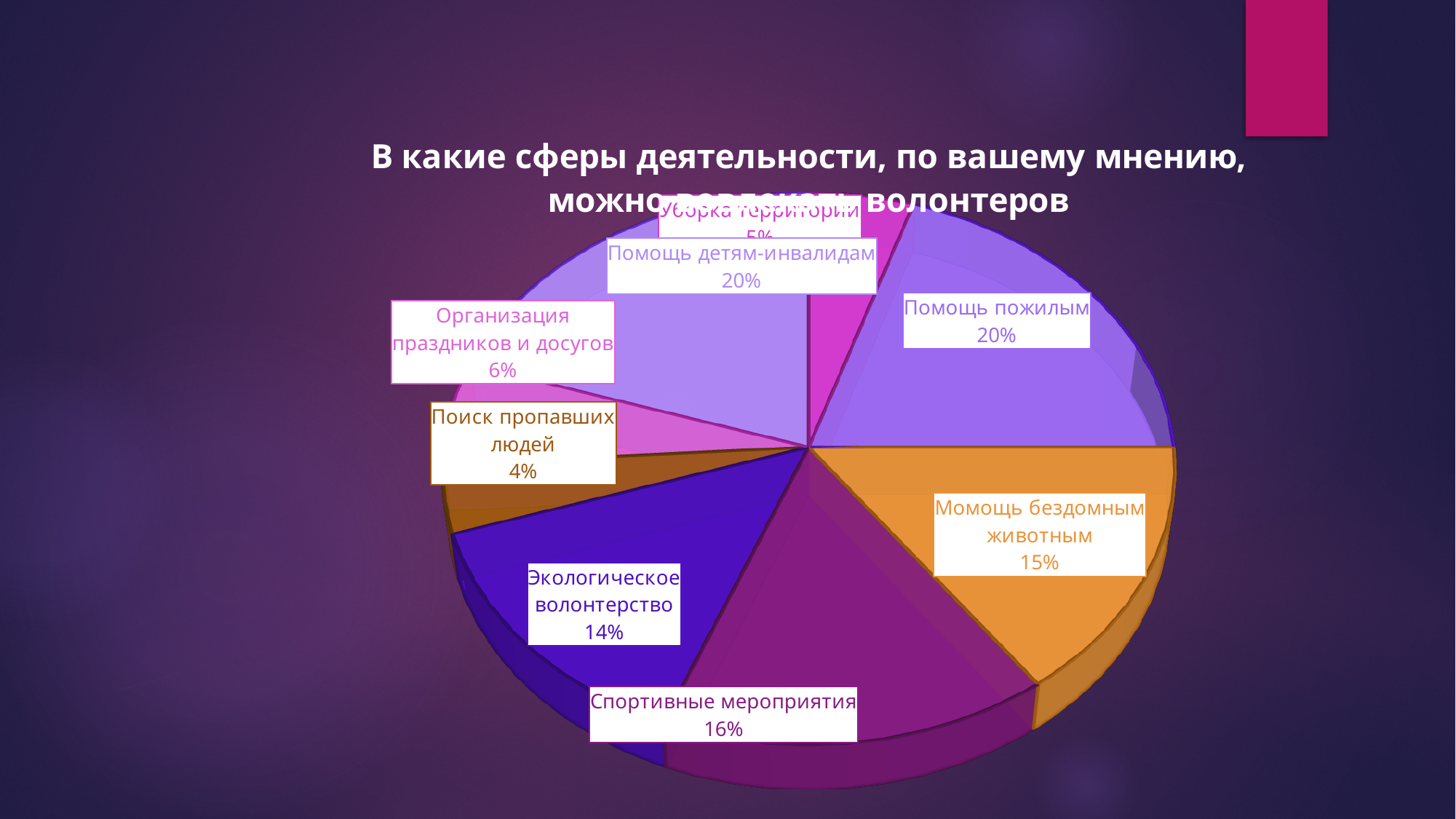
What kind of chart is shown on the slide? pie chart What is the value for "Спортивные мероприятия"? 16% What is the difference between "Помощь пожилым" and "Поиск пропавших людей"? 16% Which category has the smallest slice of the pie? Поиск пропавших людей Which is larger, "Спортивные мероприятия" or "Помощь бездомным животным"? Спортивные мероприятия How many slices does the pie chart have? 8 What is the value for "Помощь бездомным животным"? 15% What colour is the slice for "Помощь бездомным животным"? orange What is the value for "Экологическое волонтерство"? 14% What share of the pie does "Помощь пожилым" have? 20% What is the difference between "Помощь детям-инвалидам" and "Экологическое волонтерство"? 6% What is the value for "Организация праздников и досугов"? 6%